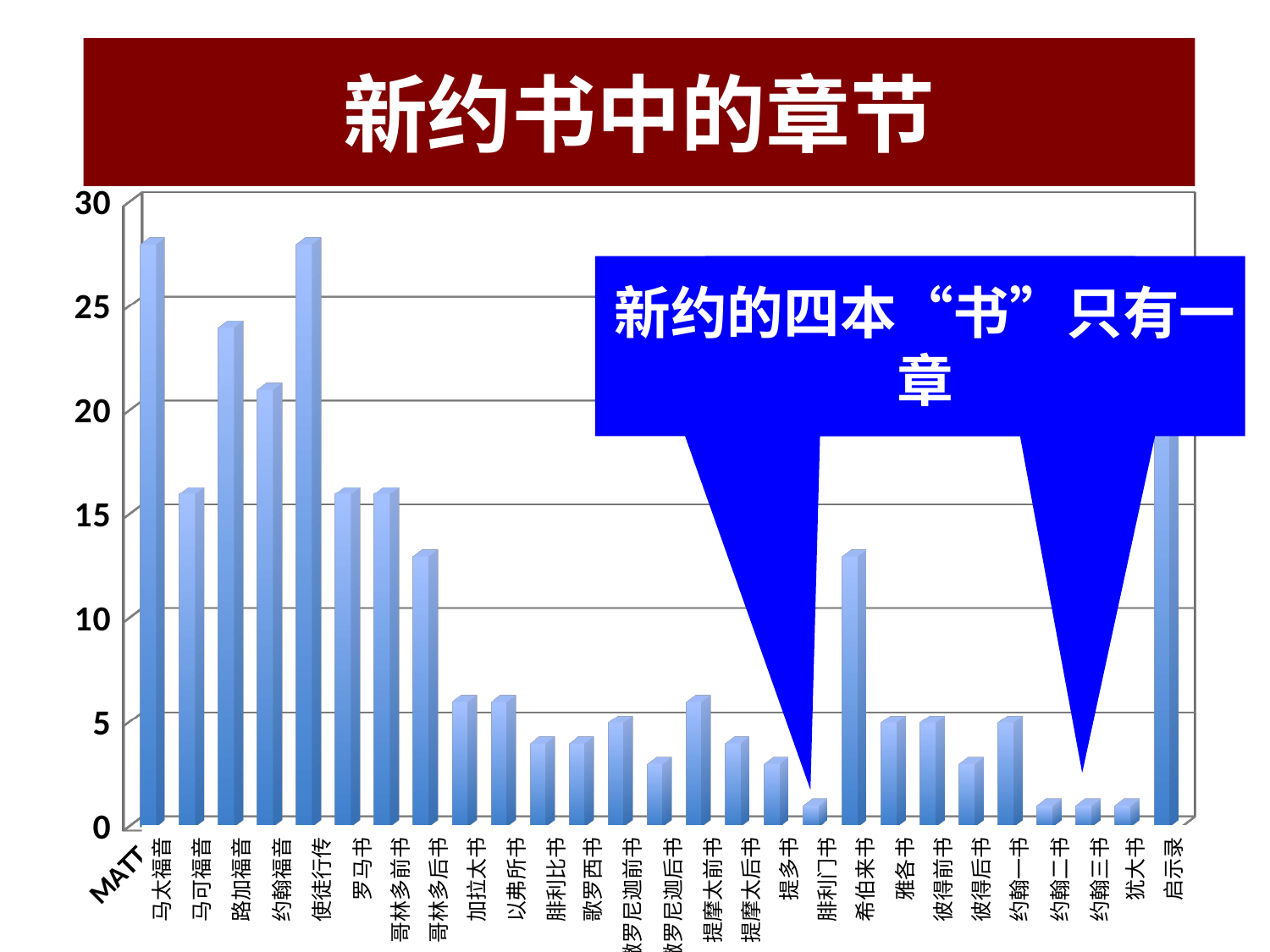
What kind of chart is shown on the slide? bar chart Which has a higher value, 马可福音 or 哥林多后书? 马可福音 What is the title of the chart? 新约书中的章节 Is the value for 哥林多后书 greater or less than 10? greater According to the callout on the chart, how many New Testament books have only one chapter? 四本 (4) Is the value for 马可福音 greater or less than 15? greater Which has a higher value, 路加福音 or 约翰福音? 路加福音 Is the value for 希伯来书 greater or less than 10? greater Which has a higher value, 希伯来书 or 雅各书? 希伯来书